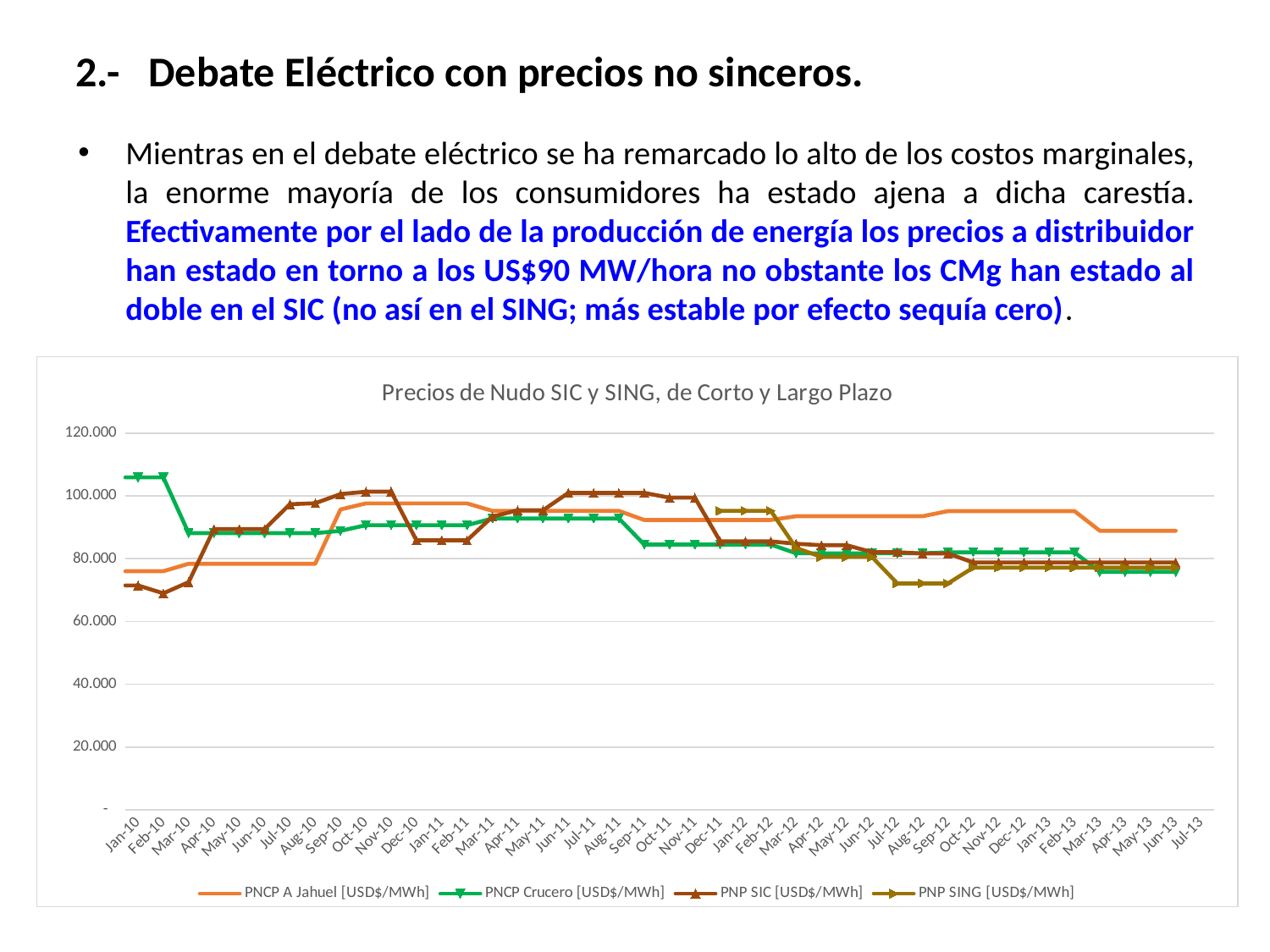
What kind of chart is shown on the slide? line chart Which series has the highest value in Jan-10? PNCP Crucero [USD$/MWh] Is the value for PNCP Crucero in Jan-10 greater or less than 100.000? greater In Feb-10, which is larger: PNCP A Jahuel or PNP SIC? PNCP A Jahuel What is the title of the chart? Precios de Nudo SIC y SING, de Corto y Largo Plazo Is the value for PNP SING in Aug-12 greater or less than 80.000? less Does the PNCP Crucero series rise or fall overall from Jan-10 to Jun-13? fall Is the value for PNP SING in Dec-11 greater or less than 80.000? greater Which series has the lowest value in Aug-12? PNP SING [USD$/MWh] Which series is plotted with the orange line without markers? PNCP A Jahuel [USD$/MWh] How many series does the chart legend list? 4